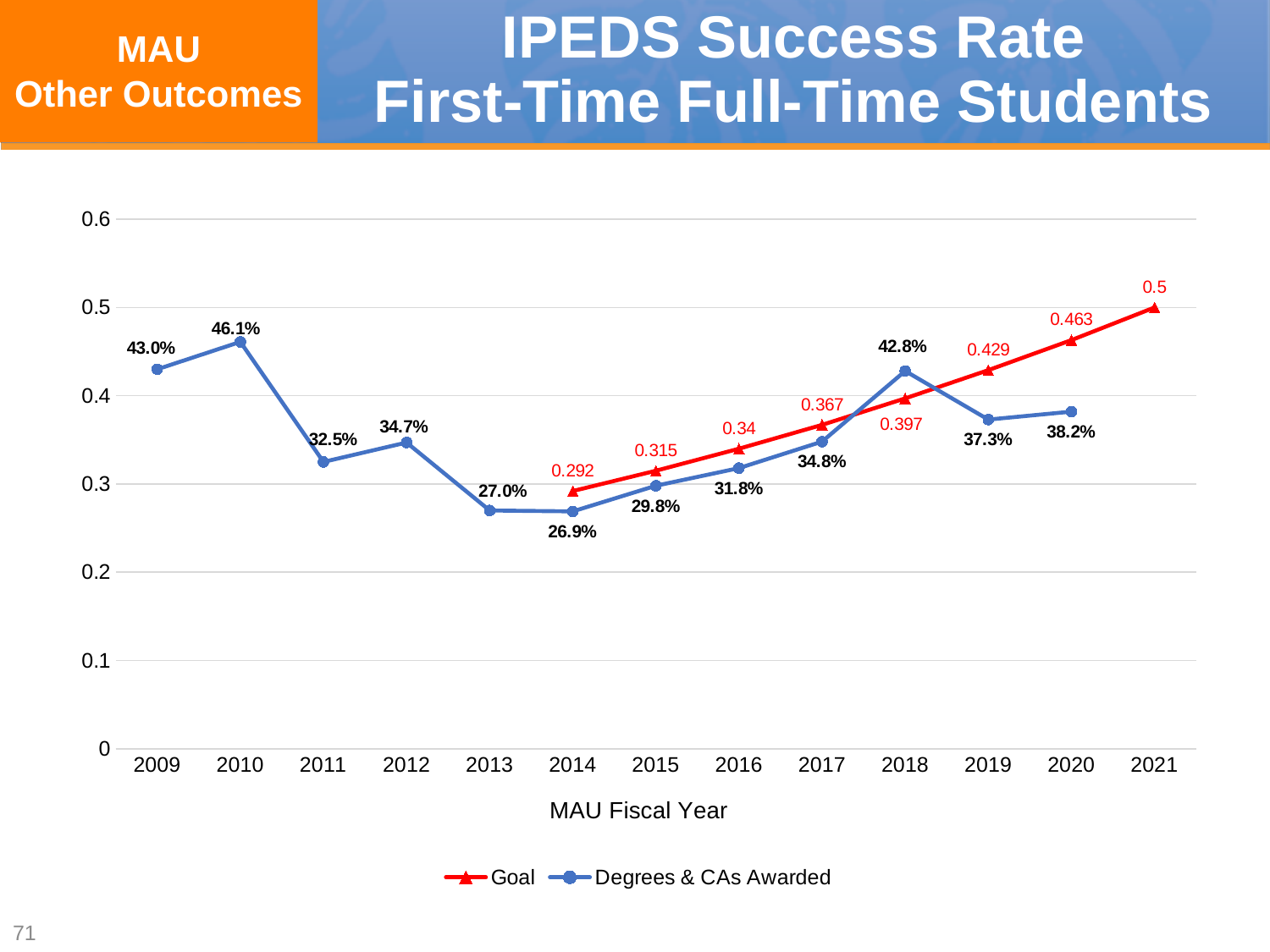
What is the Degrees & CAs Awarded value for 2018? 42.8% How many fiscal years are shown on the x axis? 13 What kind of chart is shown on the slide? Line chart What is the Degrees & CAs Awarded value for 2010? 46.1% Which is larger in 2019, the Goal value or the Degrees & CAs Awarded value? Goal What is the Goal value for 2017? 0.367 What is the Goal value for 2021? 0.5 In which fiscal year is the Degrees & CAs Awarded value lowest? 2014 What is the difference between the Degrees & CAs Awarded values for 2018 and 2017? 8.0 percentage points Does the Goal series rise or fall from 2014 to 2021? Rise In which fiscal year is the Degrees & CAs Awarded value highest? 2010 How many series does the legend list? 2